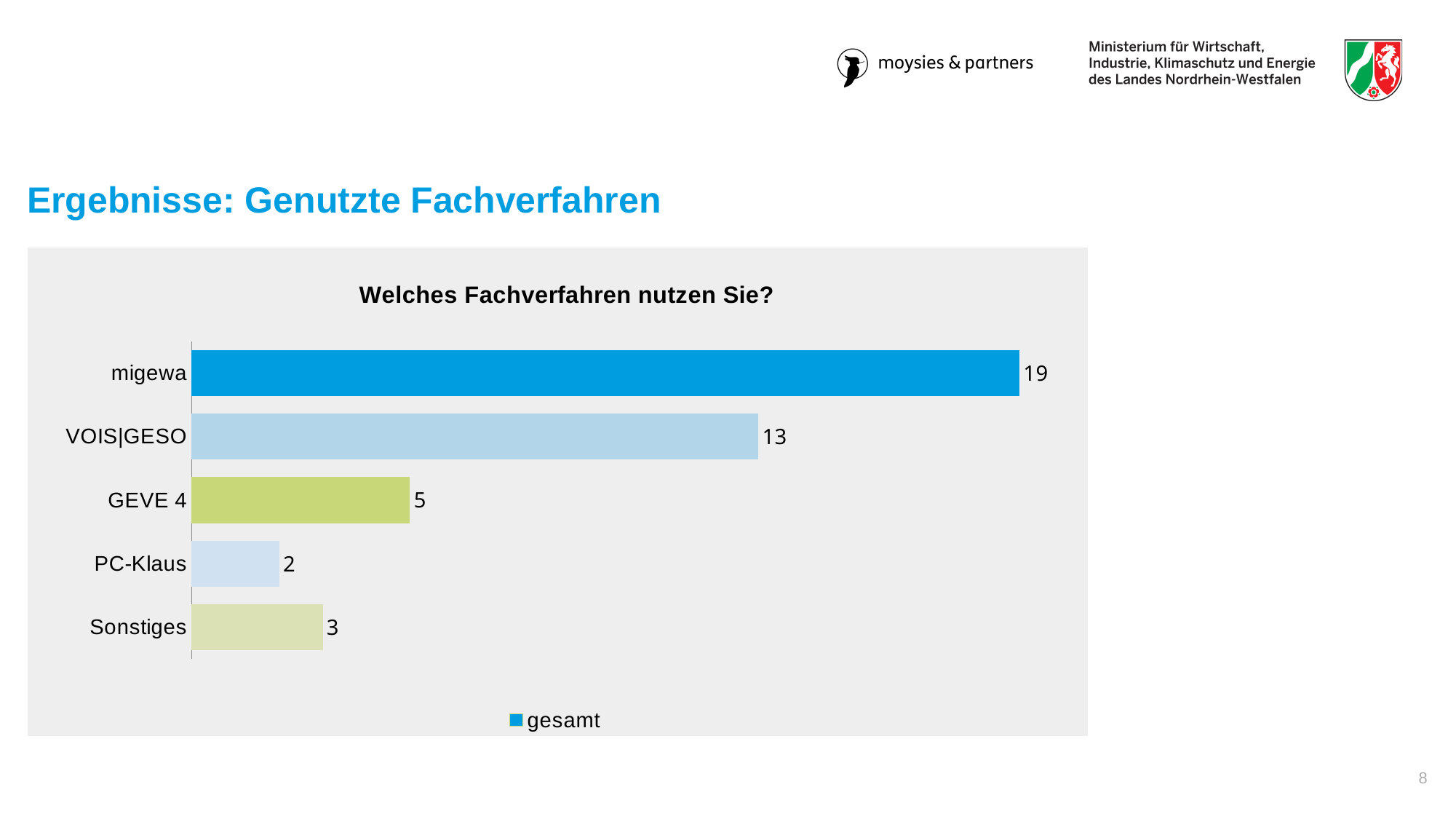
Which category has the lowest value? PC-Klaus Which is larger, the value for GEVE 4 or the value for Sonstiges? GEVE 4 What is the value for migewa? 19 What is the value for VOIS|GESO? 13 What is the value for PC-Klaus? 2 What is the value for GEVE 4? 5 What is the value for Sonstiges? 3 Which category has the highest value? migewa What is the title of the chart? Welches Fachverfahren nutzen Sie? What is the difference between the values for migewa and VOIS|GESO? 6 What kind of chart is shown on the slide? Bar chart How many categories are shown in the chart? 5